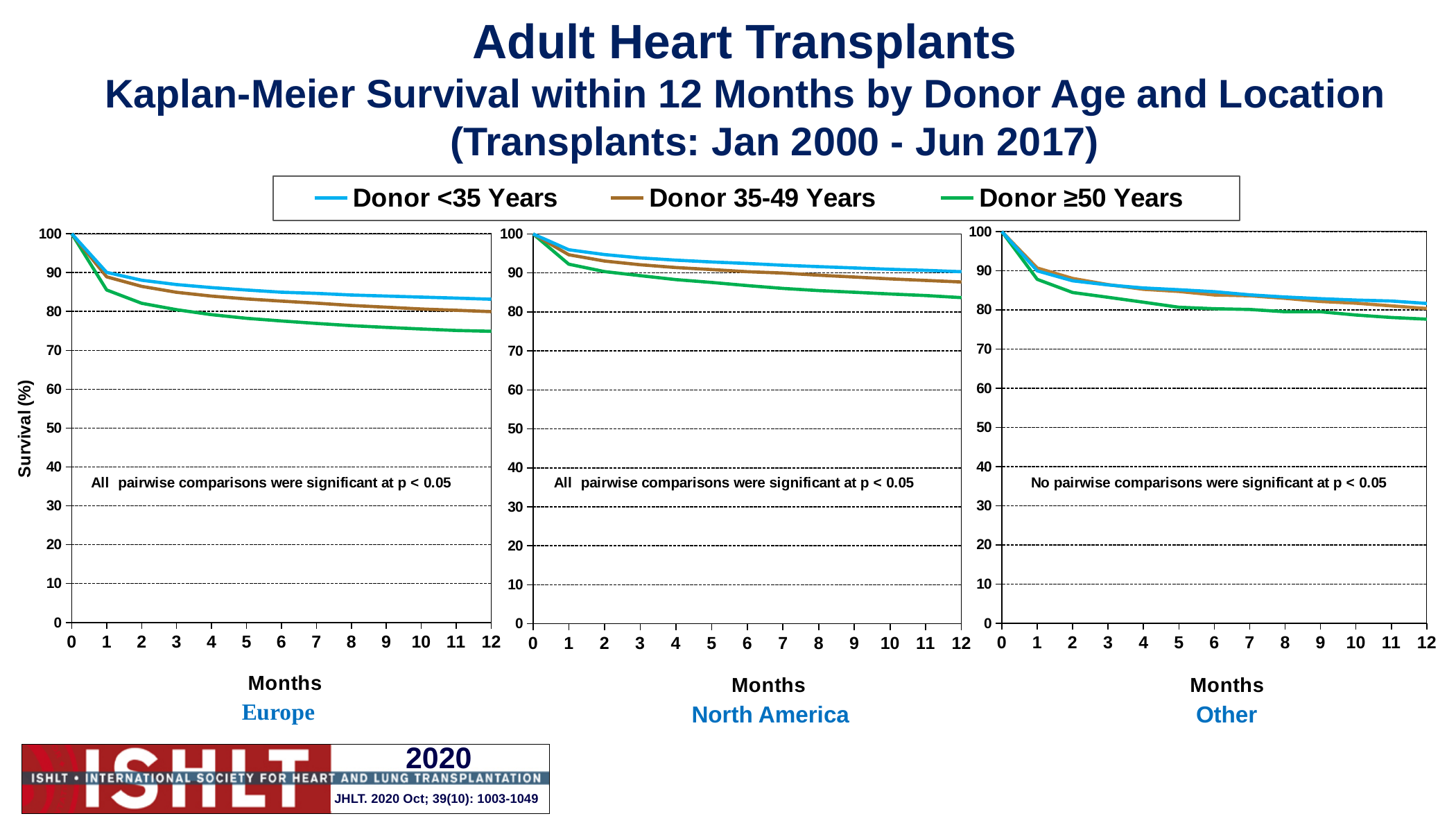
In the Other chart, is the value for Donor ≥50 Years at 12 months greater or less than 80? less In the Europe chart, is the value for Donor 35-49 Years at 6 months greater or less than 90? less How many series does the legend list? 3 In the North America chart, is the value for Donor ≥50 Years at 12 months greater or less than 80? greater In the Europe chart, does the Donor <35 Years line rise or fall from month 0 to month 12? fall What kind of chart is used in each of the three panels on the slide? line chart In the North America chart, which series has the lowest survival at 12 months? Donor ≥50 Years In the Europe chart, what is the survival value for all series at month 0? 100 In the Europe chart, which is larger at 12 months: Donor <35 Years or Donor ≥50 Years? Donor <35 Years Which chart states that no pairwise comparisons were significant at p < 0.05? Other